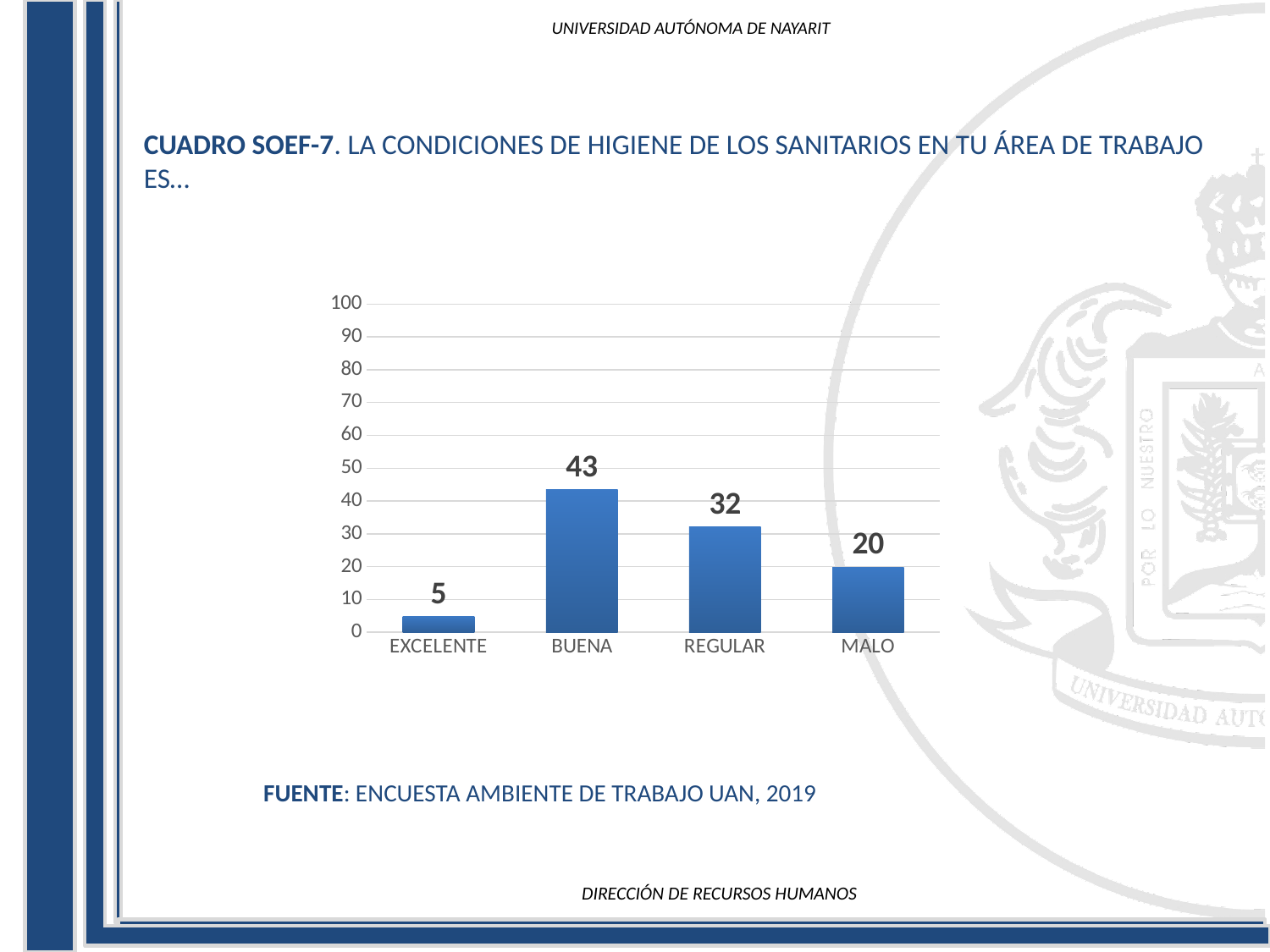
What kind of chart is shown on the slide? bar chart Which is larger, the value for REGULAR or the value for MALO? REGULAR What is the difference between the values for BUENA and REGULAR? 11 What is the value for BUENA? 43 Which category has the lowest value? EXCELENTE Is the value for BUENA greater or less than 50? less What is the source cited below the chart? ENCUESTA AMBIENTE DE TRABAJO UAN, 2019 Which category has the highest value? BUENA What is the difference between the values for REGULAR and MALO? 12 What is the value for EXCELENTE? 5 How many categories are shown on the x axis? 4 What is the value for MALO? 20